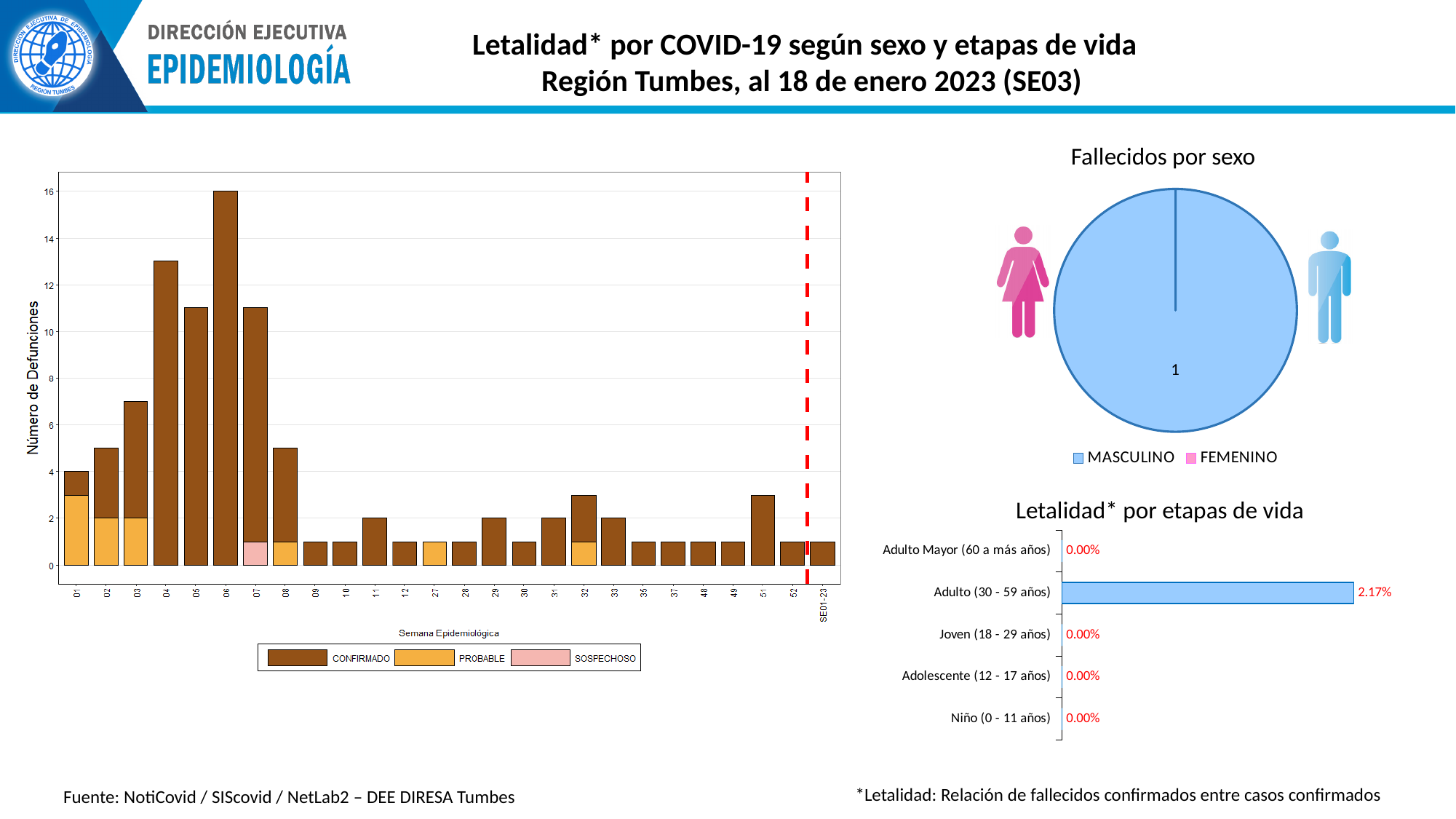
In the 'Letalidad* por etapas de vida' chart, what is the difference between the values for Adulto (30 - 59 años) and Joven (18 - 29 años)? 2.17% In the 'Letalidad* por etapas de vida' chart, what is the value for Adulto Mayor (60 a más años)? 0.00% How many series does the legend of the 'Fallecidos por sexo' pie chart list? 2 What kind of chart is 'Fallecidos por sexo'? Pie chart In the stacked bar chart on the left (Número de Defunciones), what is the total number of deaths for week 06? 16 In the stacked bar chart on the left (Número de Defunciones), which epidemiological week has the highest total number of deaths? 06 In the stacked bar chart on the left (Número de Defunciones), is the total for week 04 greater or less than 12? greater How many age-group categories are shown in the 'Letalidad* por etapas de vida' chart? 5 What kind of chart is 'Letalidad* por etapas de vida'? Bar chart In the 'Letalidad* por etapas de vida' chart, which age group has the highest value? Adulto (30 - 59 años) In the 'Fallecidos por sexo' pie chart, what value is printed on the pie? 1 In the 'Letalidad* por etapas de vida' chart, what is the value for Adulto (30 - 59 años)? 2.17%